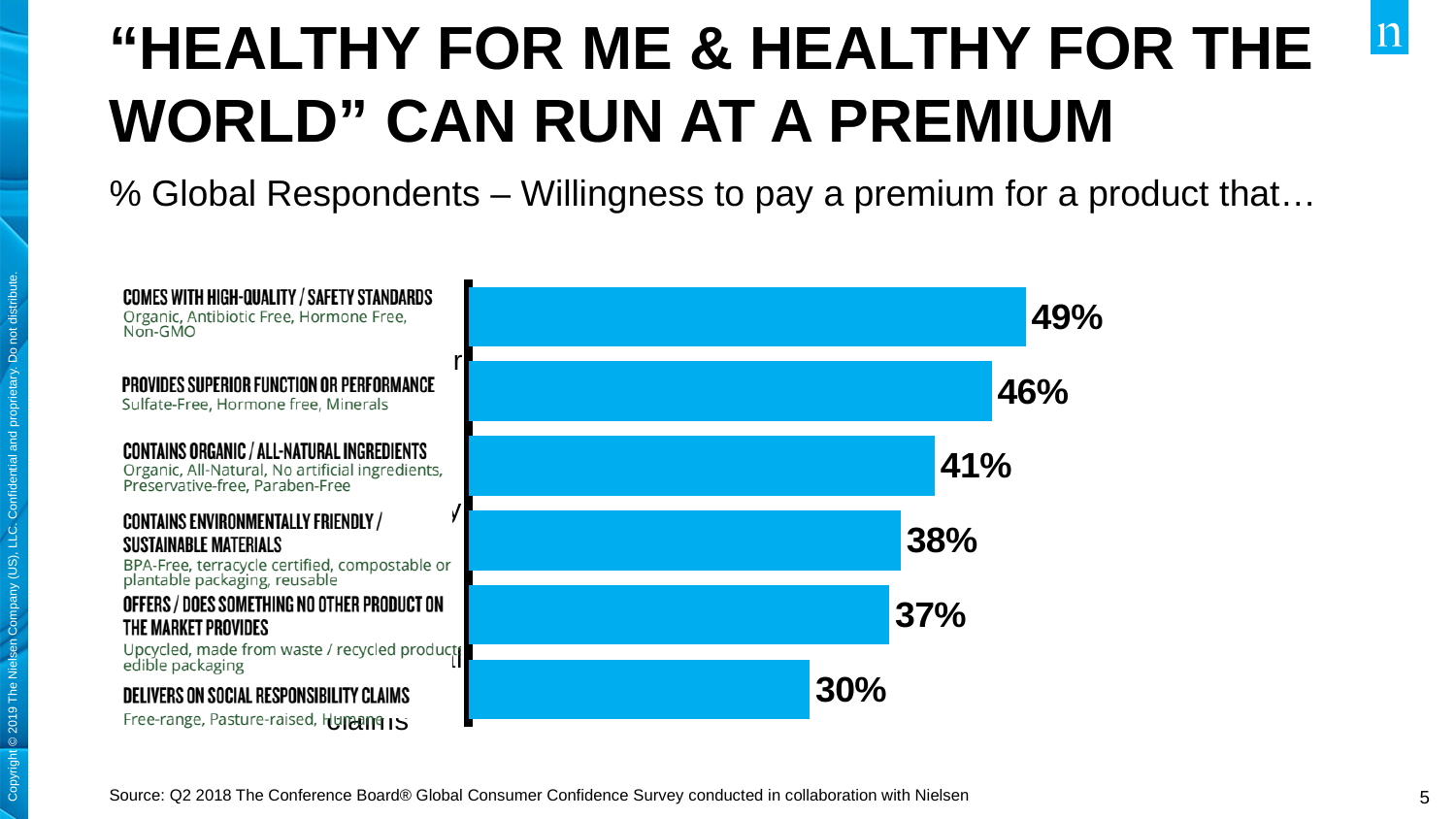
What is the difference between the values for 'Provides superior function or performance' and 'Contains environmentally friendly / sustainable materials'? 8% What is the value for 'Delivers on social responsibility claims'? 30% What percentage of global respondents are willing to pay a premium for a product that comes with high-quality / safety standards? 49% What is the difference between the values for 'Comes with high-quality / safety standards' and 'Delivers on social responsibility claims'? 19% What is the value for 'Provides superior function or performance'? 46% Which is larger: the value for 'Contains organic / all-natural ingredients' or 'Offers / does something no other product on the market provides'? Contains organic / all-natural ingredients Which category has the highest percentage of respondents willing to pay a premium? Comes with high-quality / safety standards What is the value for 'Contains environmentally friendly / sustainable materials'? 38% Which category has the lowest percentage of respondents willing to pay a premium? Delivers on social responsibility claims How many categories are shown in the chart? 6 What is the value for 'Contains organic / all-natural ingredients'? 41% What type of chart is shown on the slide? Bar chart